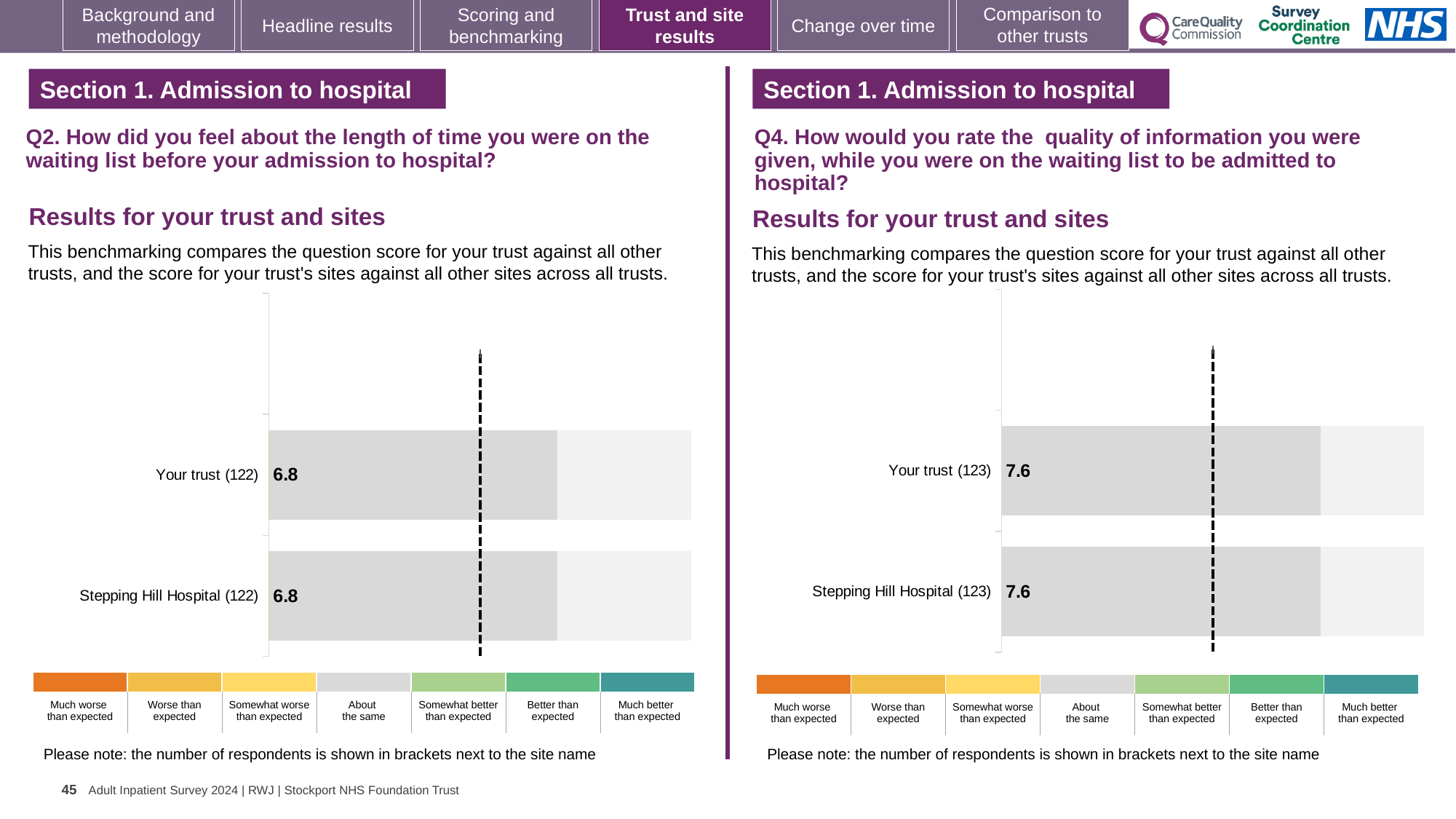
In the Q4 chart on the right, what is the difference between the score for Your trust and the score for Stepping Hill Hospital? 0 How many bars are plotted in the Q4 chart on the right? 2 Is the score for Your trust in the Q4 chart on the right larger or smaller than the score for Your trust in the Q2 chart on the left? Larger In the Q2 chart on the left, how many respondents are shown in brackets for Your trust? 122 In the Q2 chart on the left, what is the score for Stepping Hill Hospital? 6.8 How many bars are plotted in the Q2 chart on the left? 2 What kind of chart is the Q2 chart on the left? Bar chart In the Q4 chart on the right, what is the score for Stepping Hill Hospital? 7.6 In the Q4 chart on the right, what is the score for Your trust? 7.6 In the Q4 chart on the right, how many respondents are shown in brackets for Stepping Hill Hospital? 123 In the Q2 chart on the left, what is the score for Your trust? 6.8 In the Q2 chart on the left, what is the difference between the score for Your trust and the score for Stepping Hill Hospital? 0